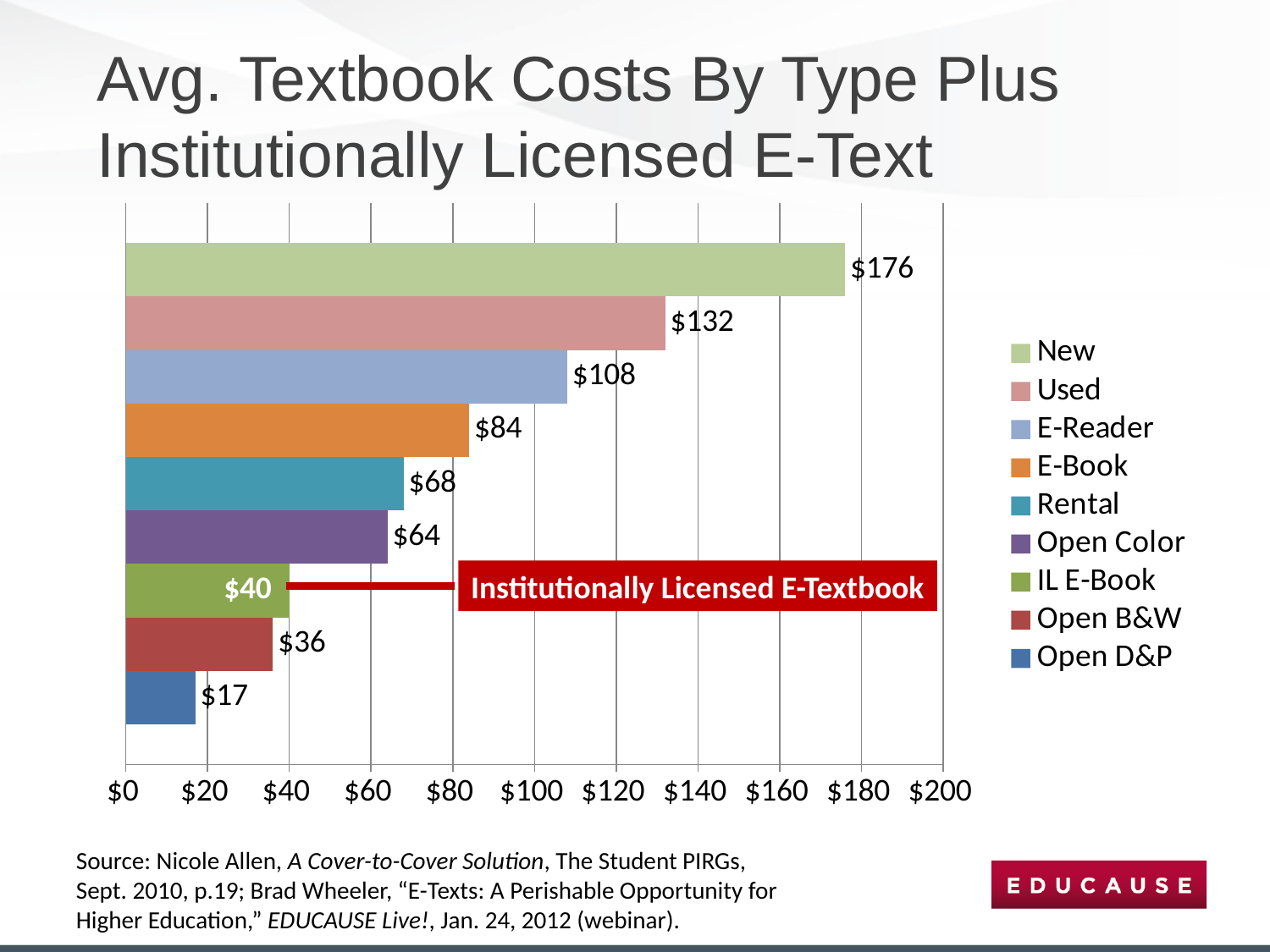
Which has a higher average cost, Rental or Open Color? Rental What is the average cost of the IL E-Book? $40 Which textbook type has the lowest average cost? Open D&P What is the average cost of a Used textbook? $132 What is the average cost of a New textbook? $176 What kind of chart is shown on the slide? Bar chart Which textbook type has the highest average cost? New What is the average cost of the Open D&P option? $17 What label does the red callout box in the chart show? Institutionally Licensed E-Textbook What is the difference in average cost between E-Reader and E-Book? $24 What is the difference in average cost between New and Used textbooks? $44 How many textbook types are shown in the chart? 9